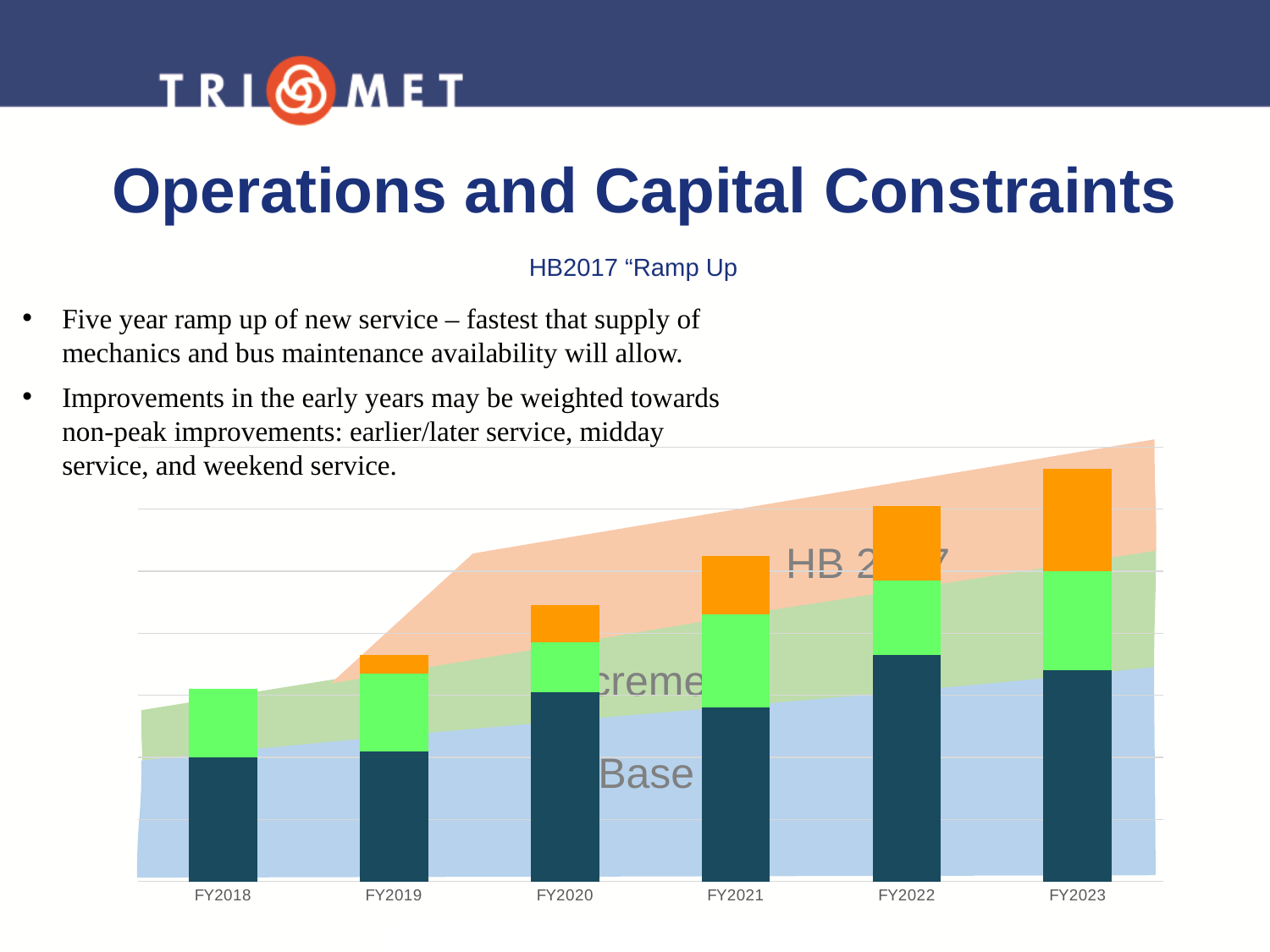
Which is the first fiscal year in which the bar includes an orange segment? FY2019 What is the first category label on the x axis of the chart? FY2018 Which stacked bar is taller, FY2020 or FY2022? FY2022 Which stacked bar is taller, FY2021 or FY2019? FY2021 What is the last category label on the x axis of the chart? FY2023 Which fiscal year has the tallest stacked bar? FY2023 How many fiscal years are shown on the x axis of the chart? 6 Do the stacked bar heights rise or fall from FY2018 to FY2023? Rise What label is shown on the lowest (blue) area of the chart? Base What kind of chart is shown on the slide? Stacked bar chart Which fiscal year has the shortest stacked bar? FY2018